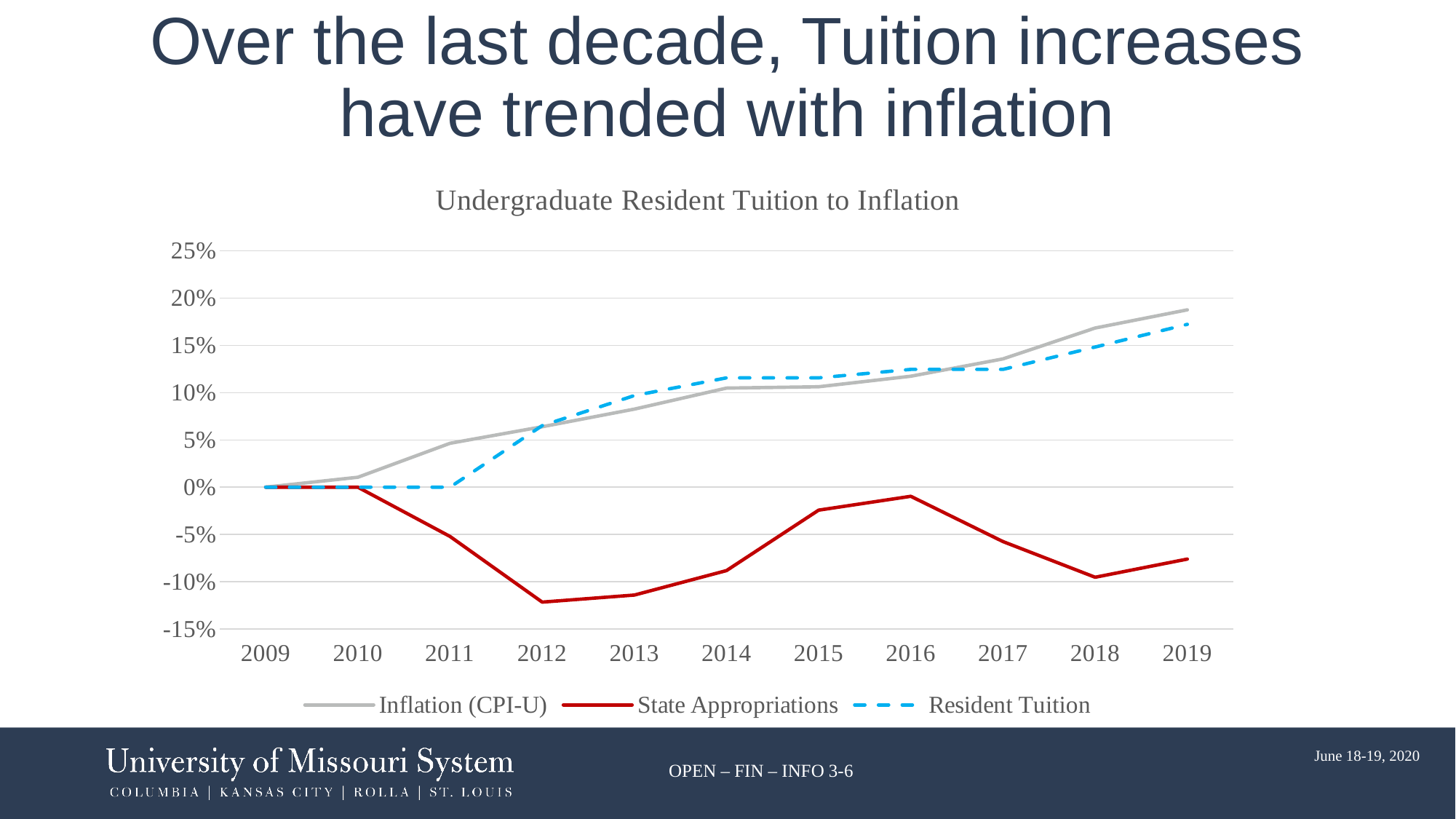
Does Inflation (CPI-U) rise or fall from 2009 to 2019? Rise Is the value for State Appropriations in 2016 greater or less than -5%? greater What type of chart is shown on the slide? Line chart In 2019, which is higher: Inflation (CPI-U) or Resident Tuition? Inflation (CPI-U) In which year is Inflation (CPI-U) at its highest? 2019 In which year is State Appropriations at its lowest? 2012 Is the value for State Appropriations in 2012 greater or less than -10%? less What is the title of the chart? Undergraduate Resident Tuition to Inflation How many series does the legend list? 3 Is the value for Inflation (CPI-U) in 2019 greater or less than 15%? greater How many years are shown on the x axis? 11 What is the value for State Appropriations in 2009? 0%